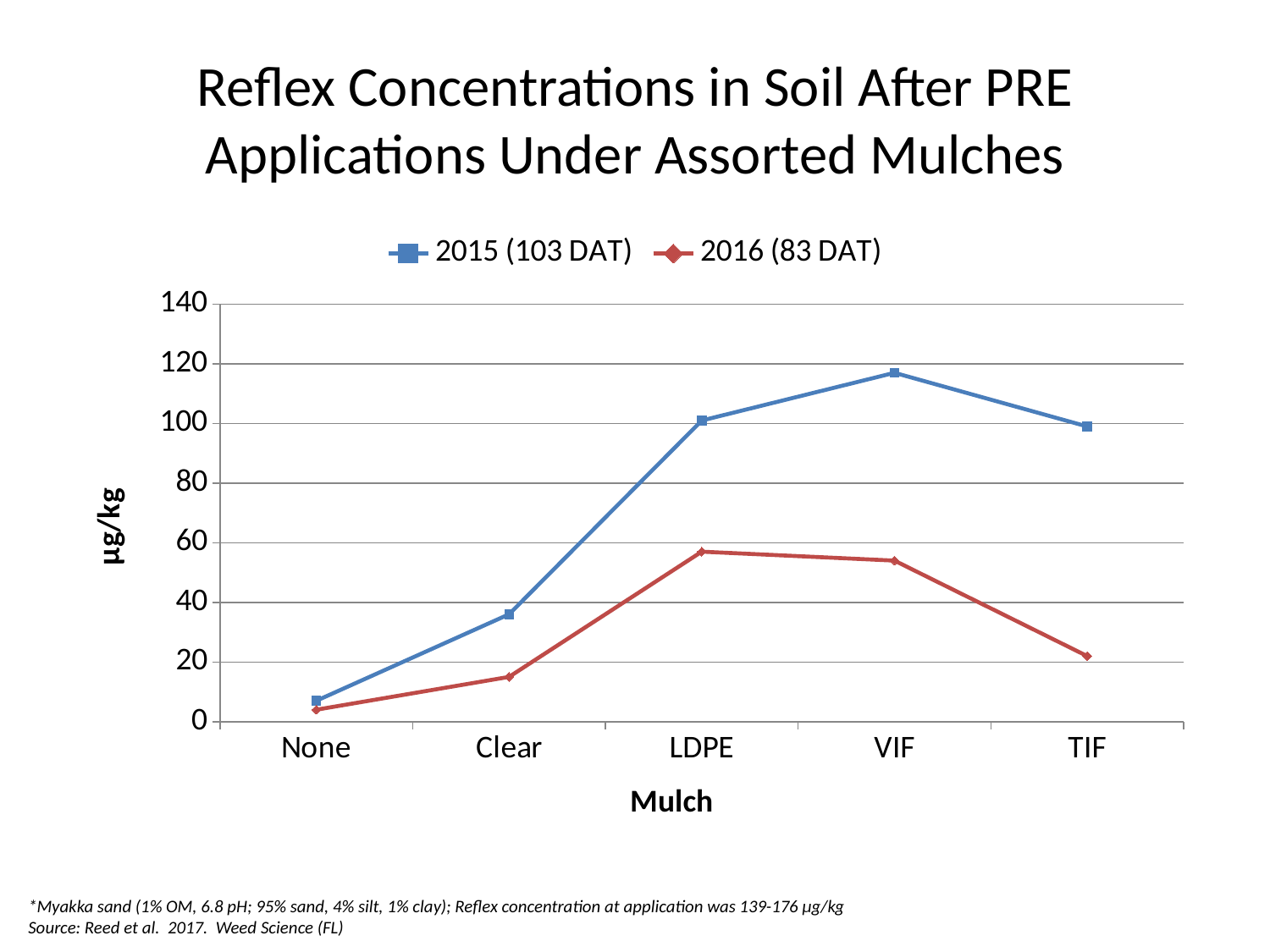
Is the 2015 (103 DAT) value for Clear greater or less than 40? less How many series does the legend list? 2 Which mulch has the highest value for the 2015 (103 DAT) series? VIF Which mulch has the lowest value for the 2015 (103 DAT) series? None Is the 2016 (83 DAT) value for LDPE greater or less than 40? greater For LDPE, which series has the larger value, 2015 (103 DAT) or 2016 (83 DAT)? 2015 (103 DAT) Is the 2016 (83 DAT) value for TIF greater or less than 40? less What kind of chart is shown on the slide? line chart How many mulch categories are plotted on the x axis? 5 Which mulch has the lowest value for the 2016 (83 DAT) series? None What is the label on the y axis? µg/kg